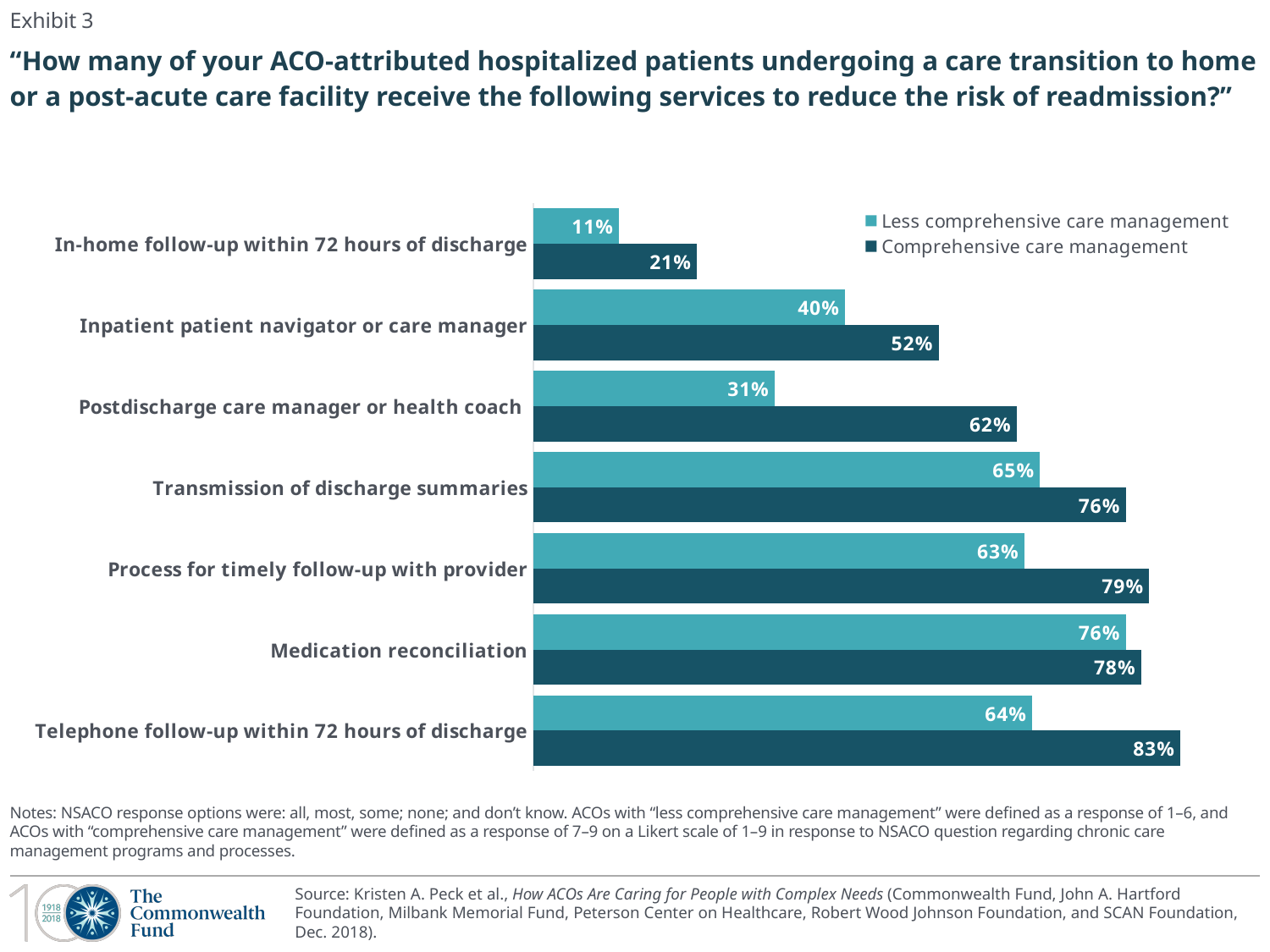
How many series does the legend list? 2 Which is larger for Inpatient patient navigator or care manager: Less comprehensive care management or Comprehensive care management? Comprehensive care management Which category has the lowest value for Less comprehensive care management? In-home follow-up within 72 hours of discharge What is the difference between the Comprehensive and Less comprehensive care management values for Postdischarge care manager or health coach? 31% How many service categories are shown in the chart? 7 What is the value for Less comprehensive care management for Postdischarge care manager or health coach? 31% Which category has the highest value for Comprehensive care management? Telephone follow-up within 72 hours of discharge What kind of chart is shown on the slide? Bar chart What is the difference between the Comprehensive and Less comprehensive care management values for Telephone follow-up within 72 hours of discharge? 19% What is the value for Less comprehensive care management for In-home follow-up within 72 hours of discharge? 11% What is the value for Comprehensive care management for Telephone follow-up within 72 hours of discharge? 83% Which legend entry is shown in the darker blue colour? Comprehensive care management